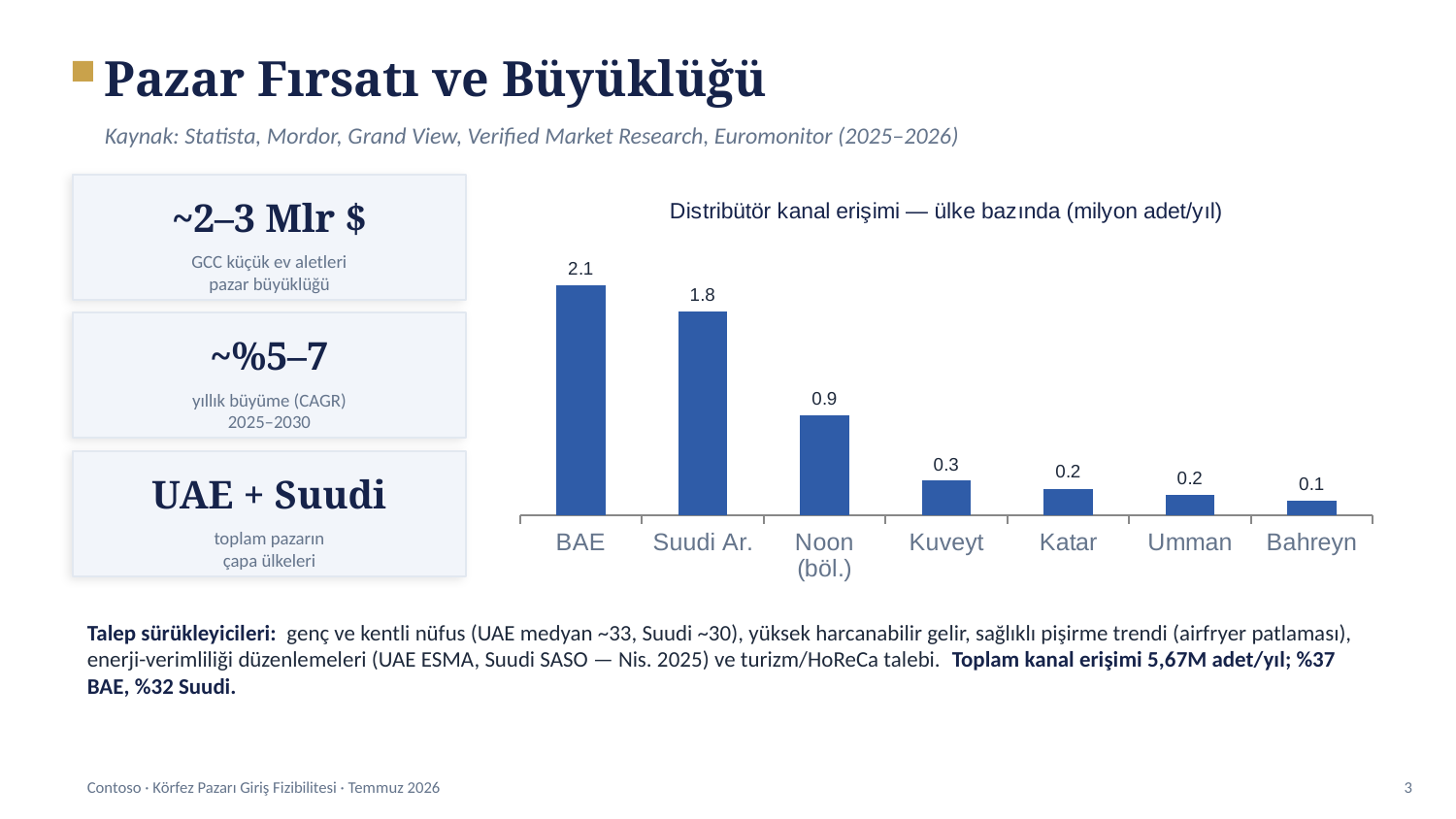
What is the value for BAE in the chart? 2.1 What is the title of the chart? Distribütör kanal erişimi — ülke bazında (milyon adet/yıl) What is the difference between the values for BAE and Suudi Ar.? 0.3 What kind of chart is shown on the slide? Bar chart What is the value for Noon (böl.) in the chart? 0.9 Which category has the lowest value in the chart? Bahreyn What is the value for Kuveyt in the chart? 0.3 What is the value for Bahreyn in the chart? 0.1 Which is larger, the value for Noon (böl.) or the value for Kuveyt? Noon (böl.) How many categories are shown in the chart? 7 Which category has the highest value in the chart? BAE What is the value for Suudi Ar. in the chart? 1.8